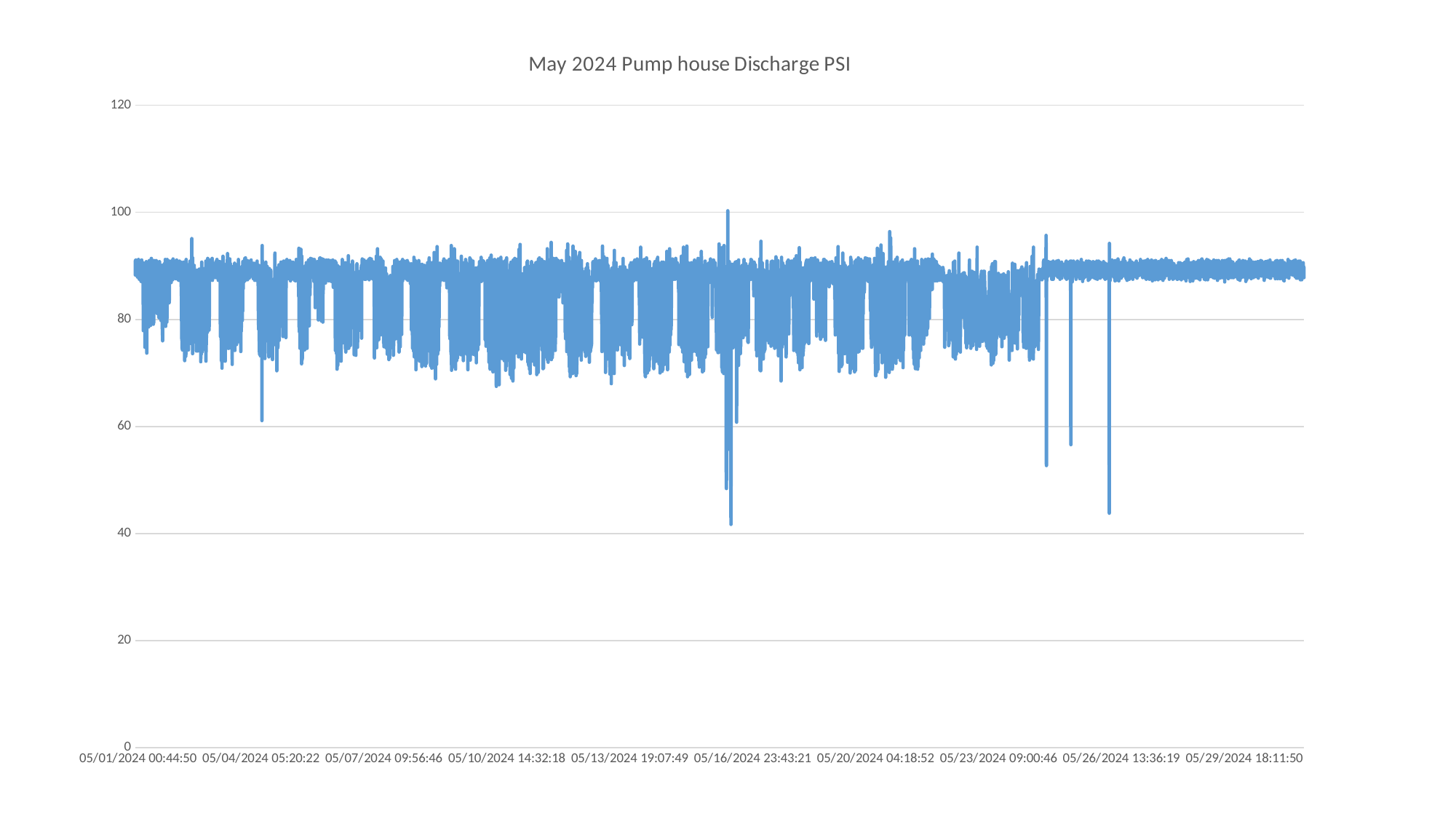
What is the title of the chart? May 2024 Pump house Discharge PSI How many tick labels are shown along the horizontal axis? 10 What is the highest value shown on the vertical axis? 120 What kind of chart is shown on the slide? line chart Is the line more stable (fewer large dips) in the last few days of the month or in the first few days? last few days Is the lowest value reached by the line greater or less than 60? less What is the first timestamp label on the horizontal axis? 05/01/2024 00:44:50 What is the last timestamp label on the horizontal axis? 05/29/2024 18:11:50 Is the typical upper level of the line, where it spends most of its time, greater or less than 80? greater Does the line ever drop below 20? No